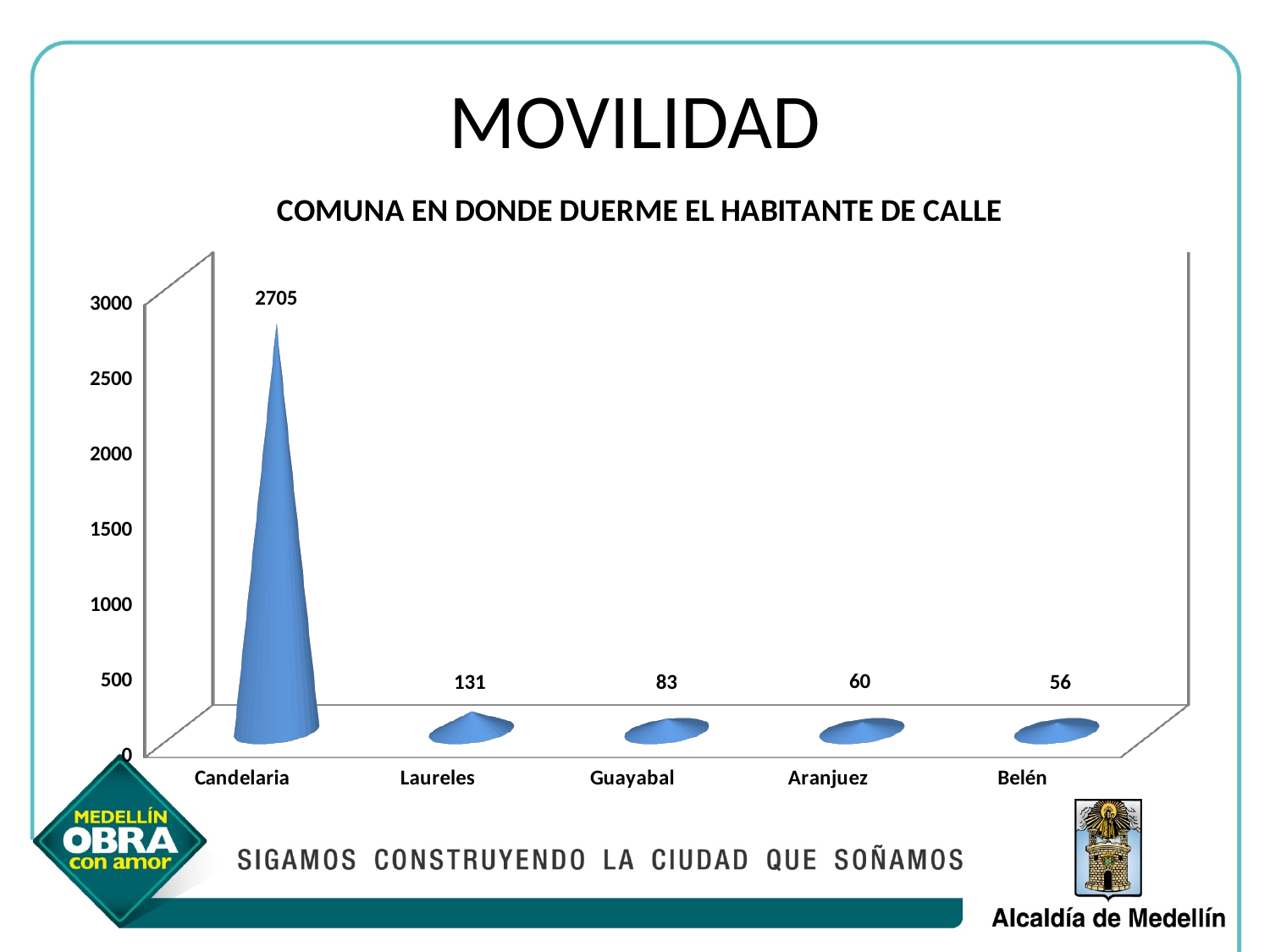
Which is larger, the value for Guayabal or the value for Aranjuez? Guayabal Which comuna has the lowest value? Belén How many comunas are shown on the x axis? 5 What is the value for Belén? 56 What is the value for Guayabal? 83 What is the value for Laureles? 131 What is the difference between the values for Candelaria and Laureles? 2574 What kind of chart is shown on the slide? Bar chart What is the difference between the values for Aranjuez and Belén? 4 What is the title of the chart? COMUNA EN DONDE DUERME EL HABITANTE DE CALLE Which comuna has the highest value? Candelaria What is the value for Candelaria? 2705